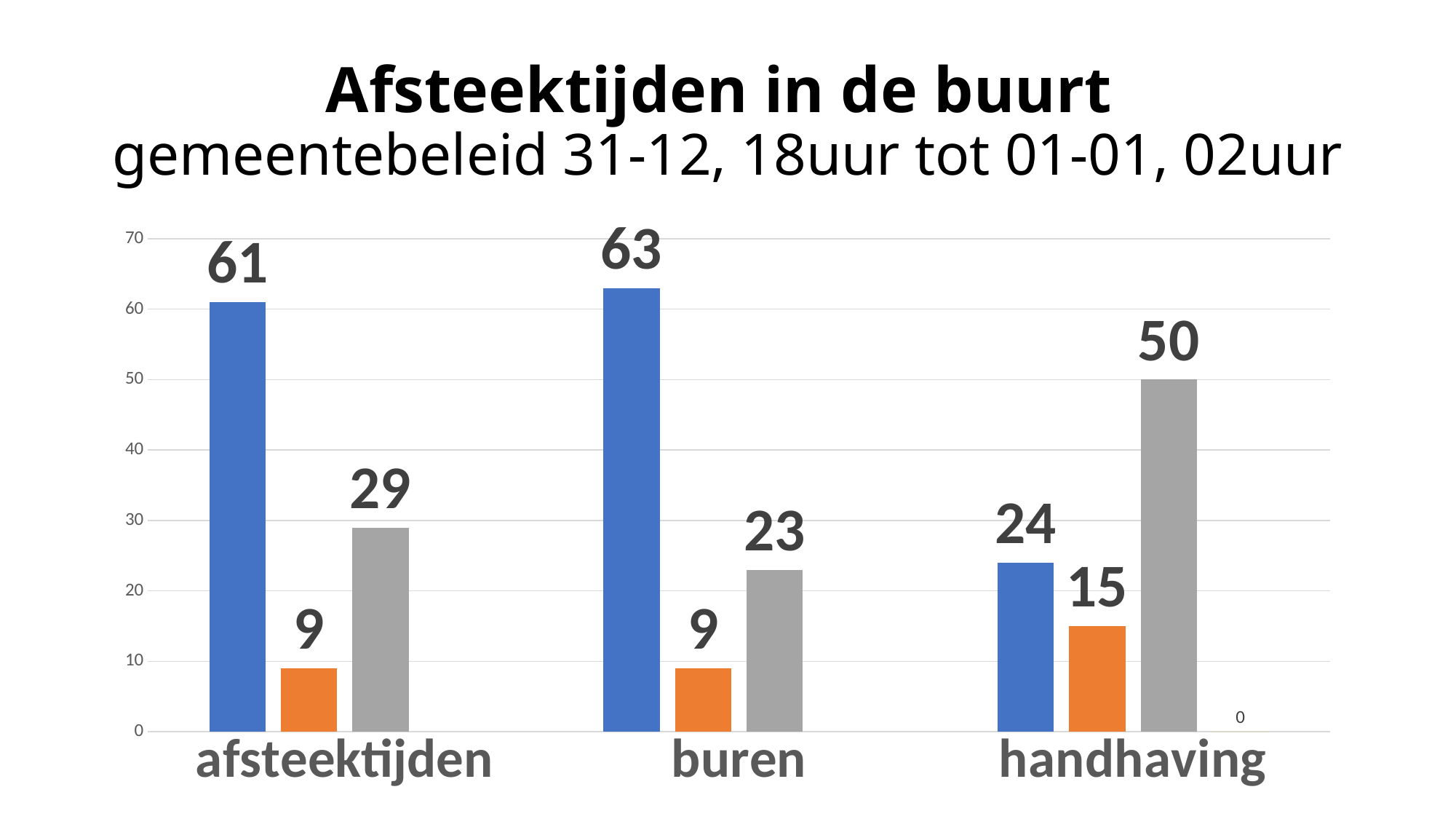
What is the difference between the blue bar for buren and the blue bar for afsteektijden? 2 How many categories are shown on the x axis? 3 What is the title of the chart? Afsteektijden in de buurt What is the value of the grey bar for afsteektijden? 29 What kind of chart is shown on the slide? bar chart What is the value of the orange bar for buren? 9 Which category has the lowest blue bar? handhaving What is the value of the grey bar for handhaving? 50 Which is larger for handhaving, the grey bar or the blue bar? the grey bar What is the difference between the grey bar for handhaving and the grey bar for buren? 27 What is the value of the blue bar for afsteektijden? 61 Which category has the highest blue bar? buren